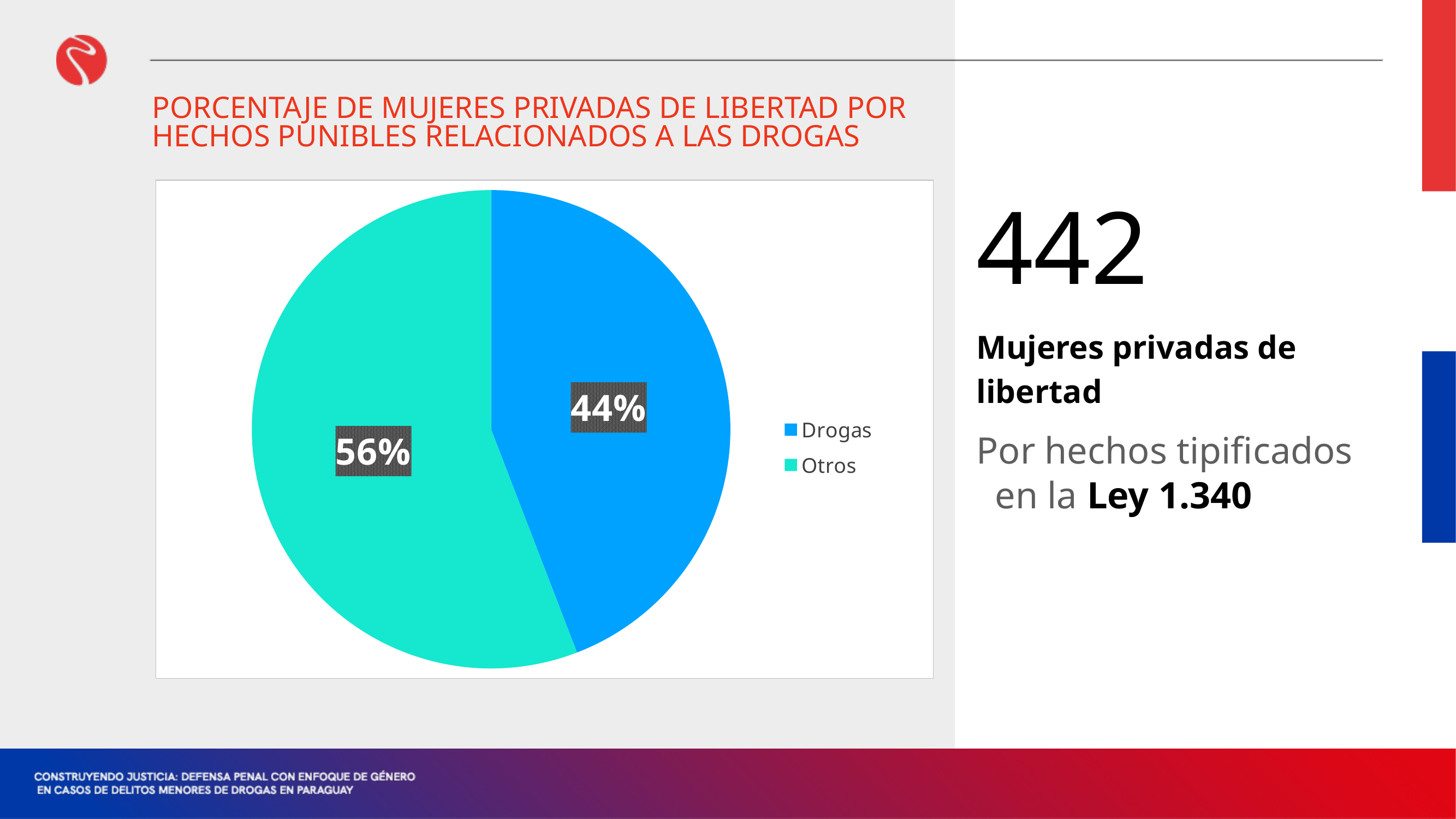
What percentage of the pie chart is labelled Otros? 56% Is the share for Drogas greater or less than 50%? less What is the title of the chart on the slide? PORCENTAJE DE MUJERES PRIVADAS DE LIBERTAD POR HECHOS PUNIBLES RELACIONADOS A LAS DROGAS Which slice of the pie chart is the largest? Otros Which slice of the pie chart is the smallest? Drogas What colour is the Drogas slice in the pie chart? blue What is the difference in percentage points between the Otros slice and the Drogas slice? 12% How many slices does the pie chart have? 2 What kind of chart is shown on the slide? pie chart Which slice is larger, Drogas or Otros? Otros What percentage of the pie chart is labelled Drogas? 44% How many entries does the legend list? 2